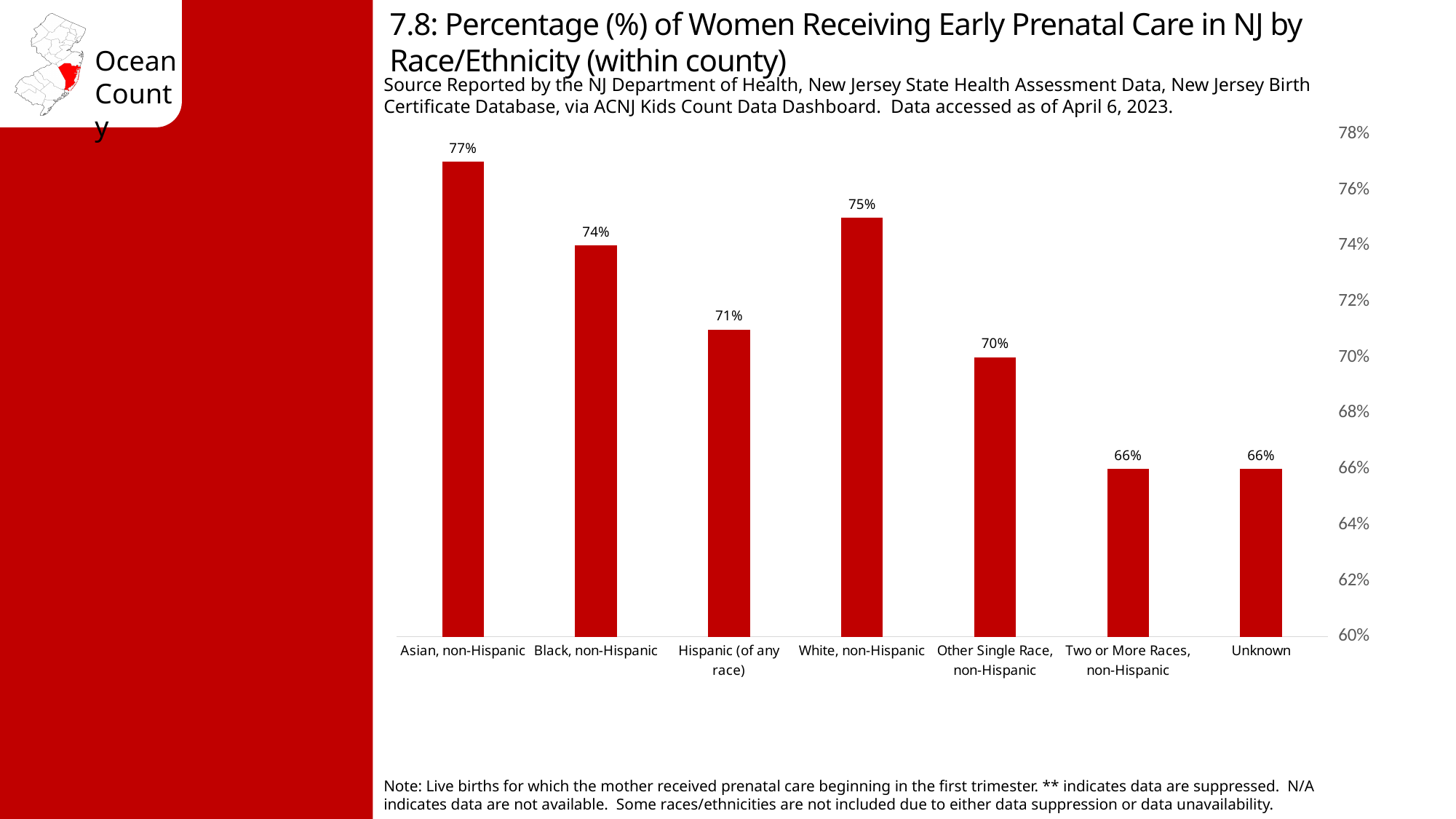
What is the value for Hispanic (of any race)? 71% What is the difference between the values for White, non-Hispanic and Two or More Races, non-Hispanic? 9% What kind of chart is shown on the slide? Bar chart What is the lowest value shown on the vertical axis? 60% Is the value for Hispanic (of any race) greater or less than 72%? less What is the difference between the values for Asian, non-Hispanic and Black, non-Hispanic? 3% How many race/ethnicity categories are shown on the chart? 7 What is the value for Unknown? 66% What is the percentage of women receiving early prenatal care for Asian, non-Hispanic? 77% What is the value for Other Single Race, non-Hispanic? 70% Which is larger, the value for Black, non-Hispanic or the value for White, non-Hispanic? White, non-Hispanic Which race/ethnicity category has the highest percentage? Asian, non-Hispanic